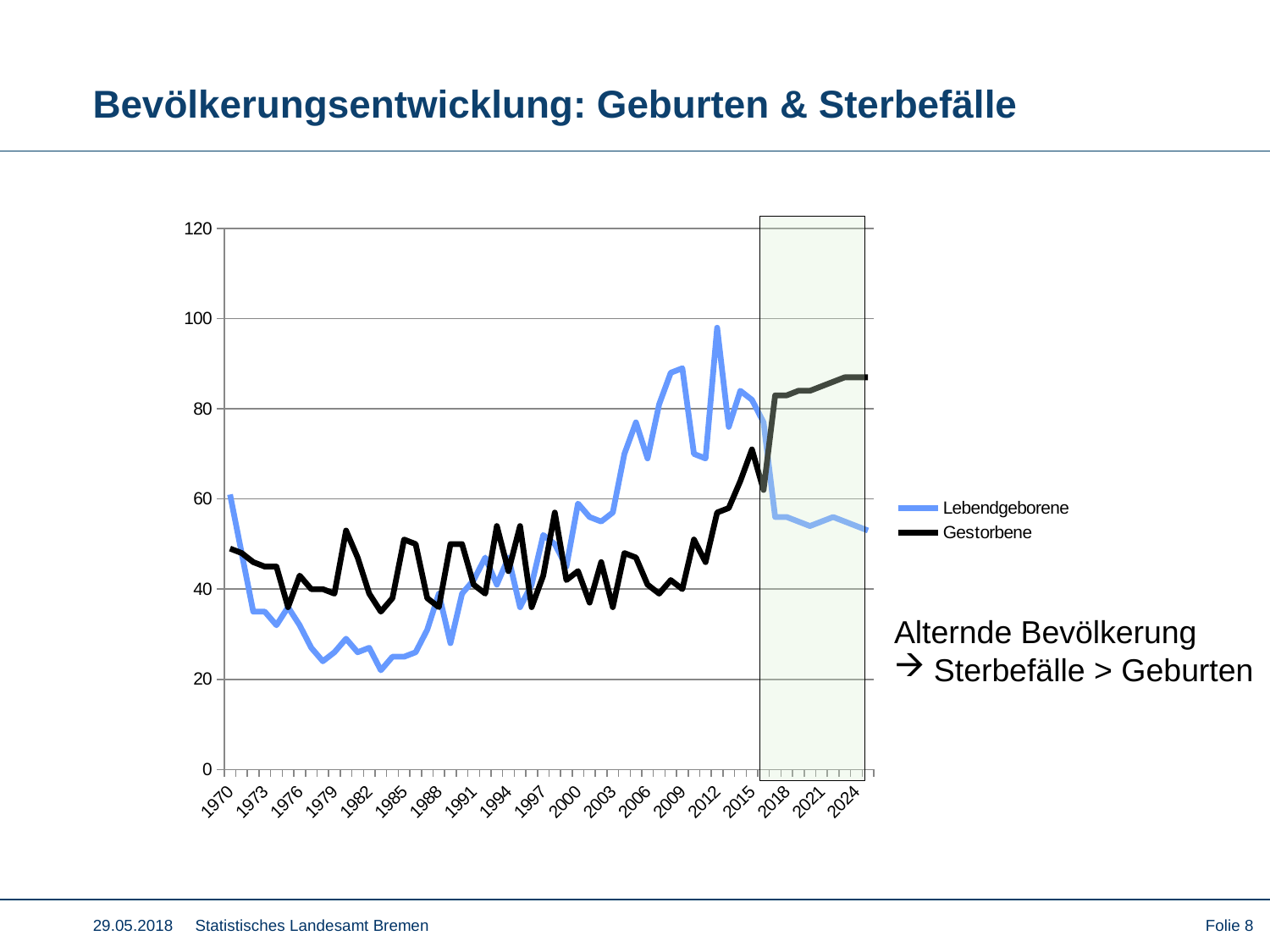
Is the value for Lebendgeborene in 1985 greater or less than 40? less Is the value for Lebendgeborene in 2012 greater or less than 80? greater Do the values for Lebendgeborene rise or fall between 1970 and 1979? fall What are the two series named in the legend? Lebendgeborene and Gestorbene Which series is drawn in blue? Lebendgeborene In 2024, which series has the higher value, Lebendgeborene or Gestorbene? Gestorbene Is the value for Lebendgeborene in 2024 greater or less than 60? less What kind of chart is shown on the slide? line chart In 1970, which series has the higher value, Lebendgeborene or Gestorbene? Lebendgeborene How many series does the legend list? 2 Do the values for Gestorbene rise or fall between 2018 and 2024? rise